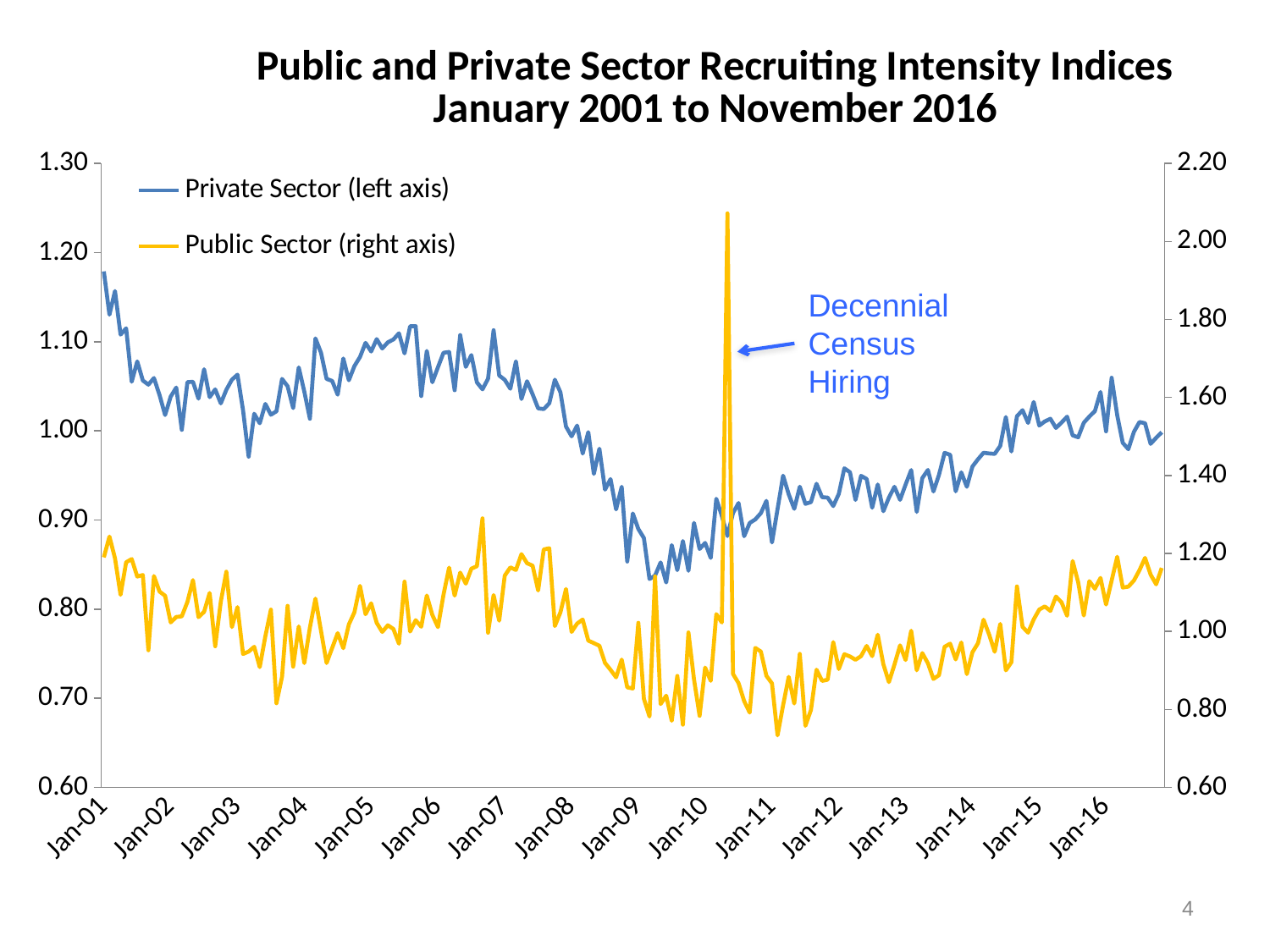
Is the Public Sector value around Jan-11 greater or less than 1.00 on the right axis? less How many year labels (Jan-01 through Jan-16) are shown on the x axis? 16 Is the lowest Private Sector value, reached around 2009, greater or less than 0.90? less Does the Private Sector series generally rise or fall between Jan-10 and Jan-16? rise What event does the annotation attribute the large spike in the Public Sector series to? Decennial Census Hiring Is the Public Sector value at Jan-01 greater or less than 1.00 on the right axis? greater What kind of chart is shown on the slide? line chart Does the Private Sector series generally rise or fall between Jan-01 and Jan-09? fall Which axis is the Public Sector series plotted against? right axis How many series does the legend list? 2